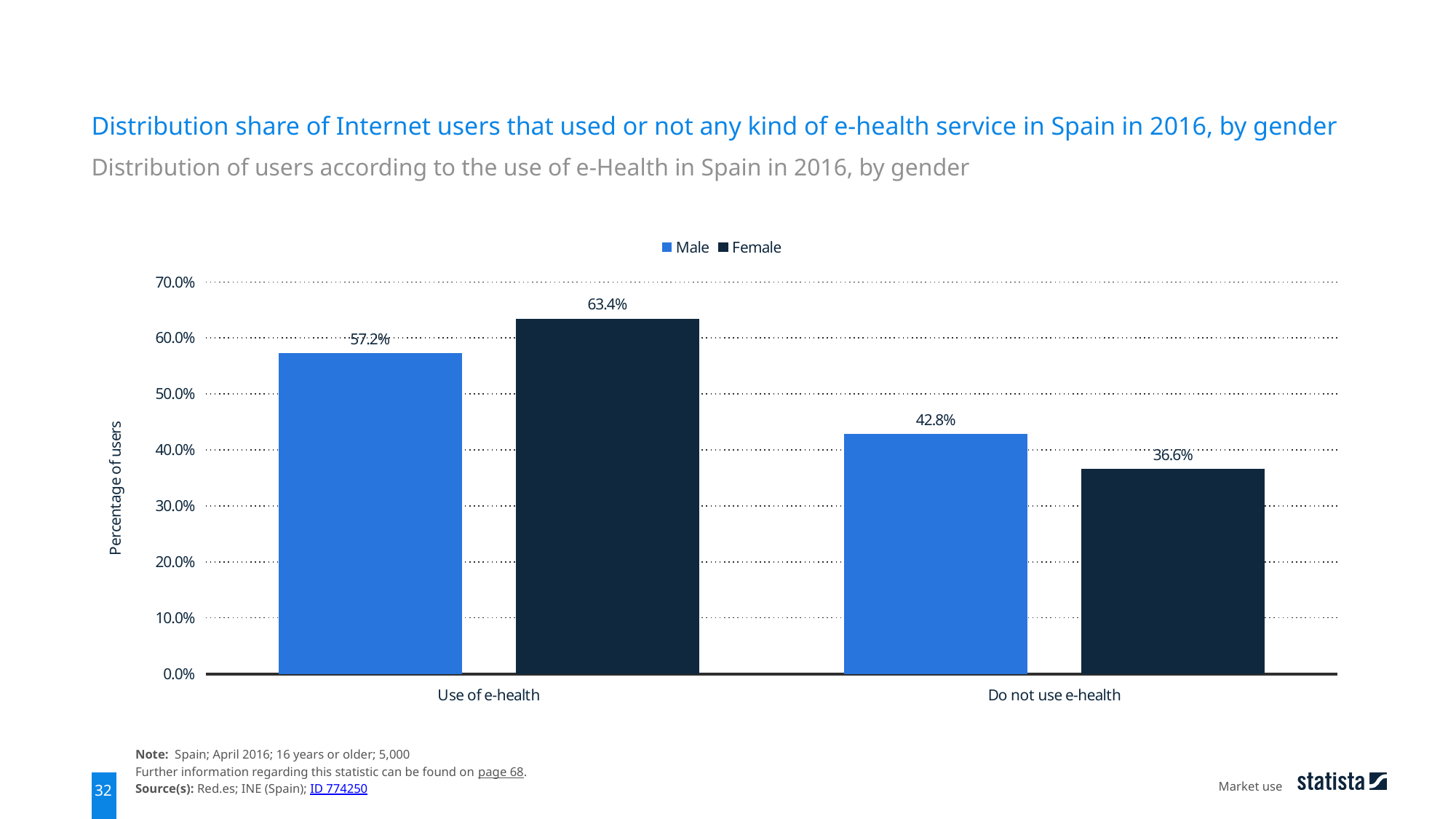
How many series does the legend list? 2 What is the Male value for "Do not use e-health"? 42.8% What is the Female value for "Use of e-health"? 63.4% Which bar has the highest value on the chart? Female, Use of e-health What is the difference between the Male and Female values for "Do not use e-health"? 6.2% What is the difference between the Female and Male values for "Use of e-health"? 6.2% For "Do not use e-health", which is larger, the Male or the Female value? Male What is the Male value for "Use of e-health"? 57.2% What is the Female value for "Do not use e-health"? 36.6% Which bar has the lowest value on the chart? Female, Do not use e-health What kind of chart is shown on the slide? Bar chart How many categories are shown on the x axis? 2